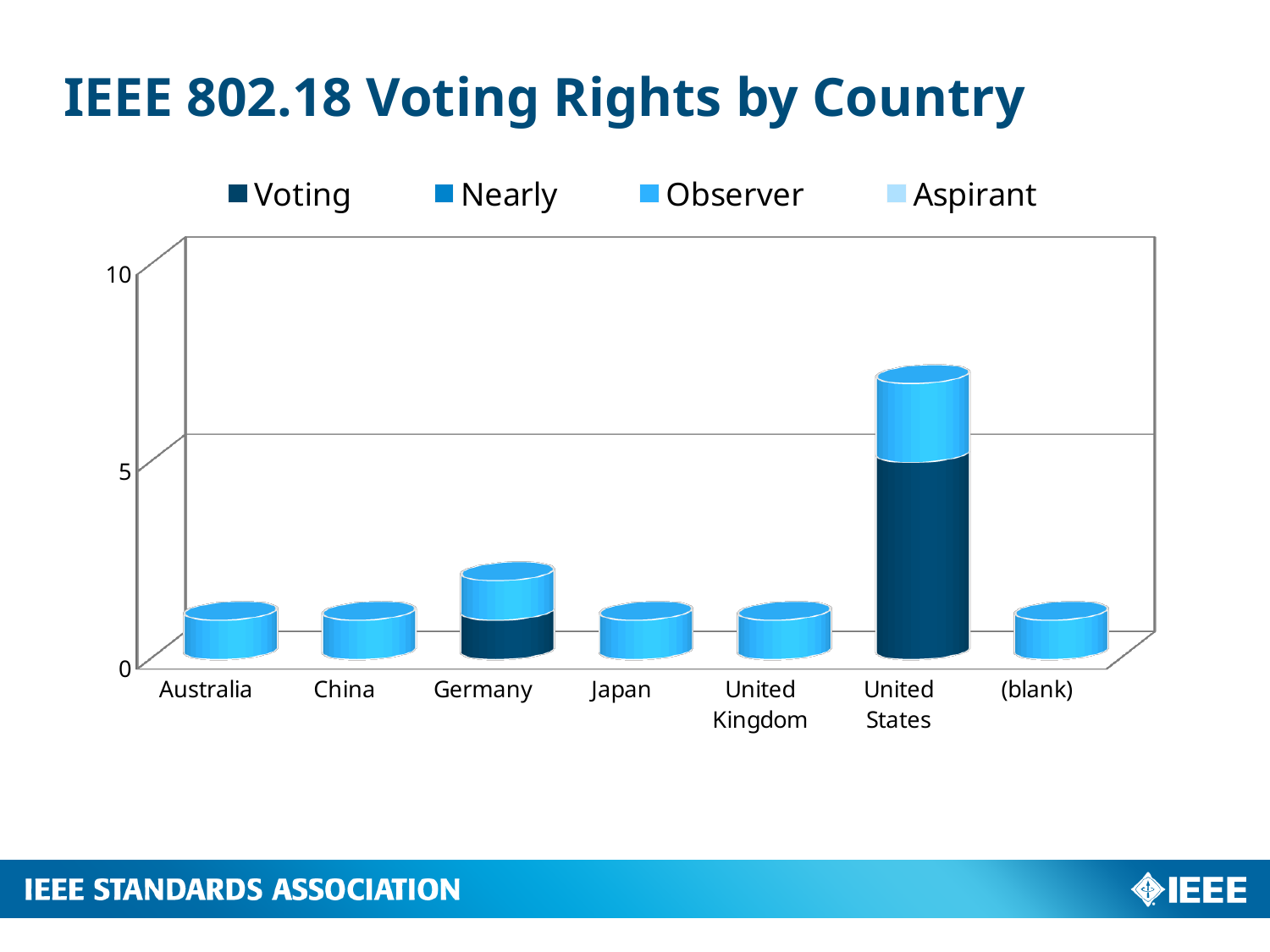
What kind of chart is shown on the slide? bar chart Is the total value for United States greater or less than 5? greater What is the title of the chart on the slide? IEEE 802.18 Voting Rights by Country Which series is listed first in the legend? Voting Which category has the tallest bar? United States Which has the larger total, United States or Germany? United States Is the total value for Germany greater or less than 5? less Which has the larger total, Germany or Australia? Germany How many categories are shown along the x axis? 7 Is the total value for United States greater or less than 10? less How many series does the legend list? 4